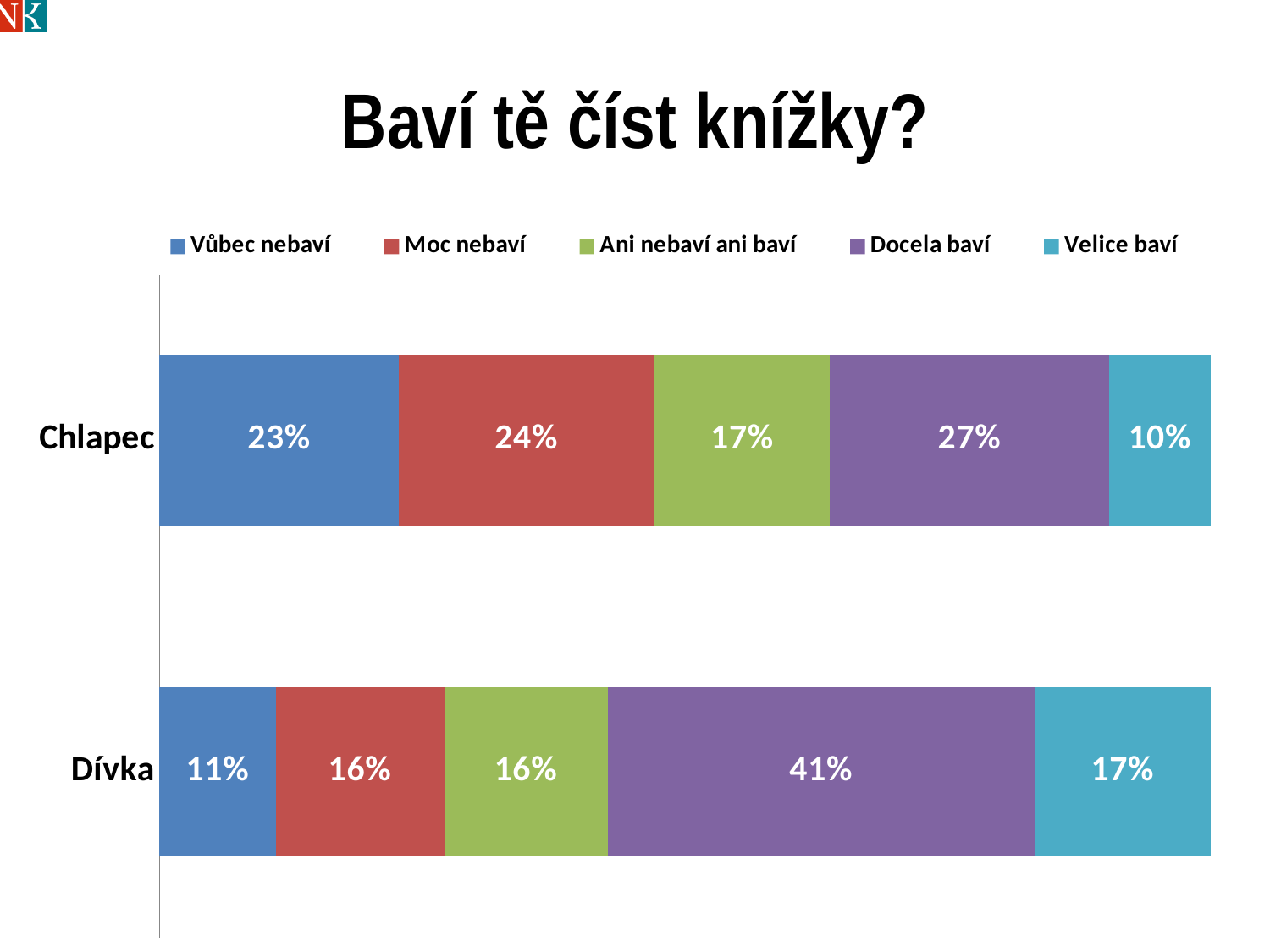
What kind of chart is shown on the slide? Stacked bar chart Which series has the lowest value in the Chlapec bar? Velice baví What is the difference between the "Docela baví" values for Dívka and Chlapec? 14% What is the value for "Vůbec nebaví" in the Dívka bar? 11% Which series has the highest value in the Dívka bar? Docela baví How many categories (bars) are shown on the chart? 2 What is the total of the Chlapec bar? 101% What is the value for "Docela baví" in the Chlapec bar? 27% Which is larger: "Vůbec nebaví" for Chlapec or "Vůbec nebaví" for Dívka? Chlapec What is the value for "Velice baví" in the Chlapec bar? 10% How many series does the legend list? 5 What is the title of the chart? Baví tě číst knížky?